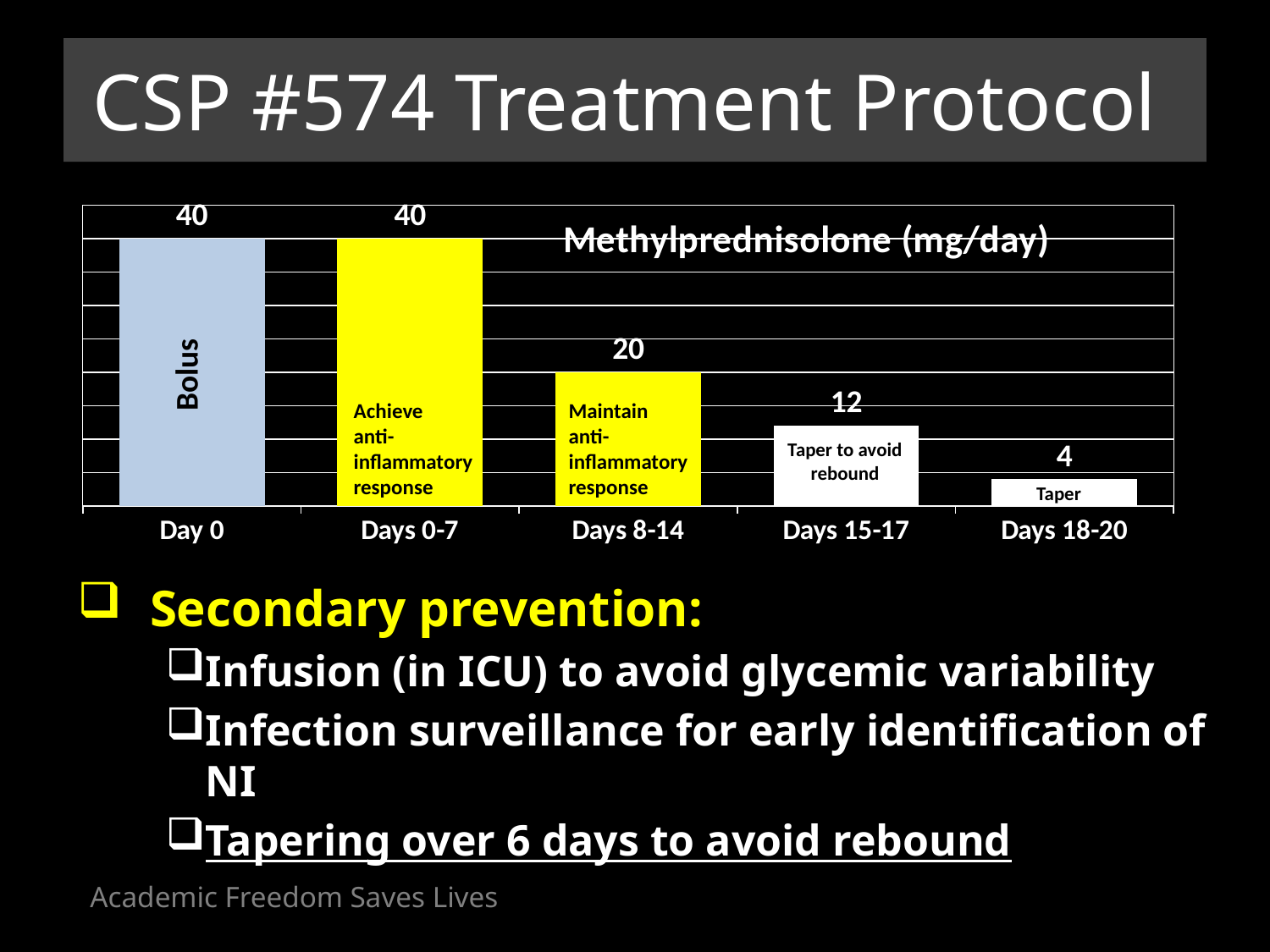
What is the methylprednisolone dose (mg/day) shown for Days 8-14? 20 Which is larger, the value for Days 8-14 or the value for Days 15-17? Days 8-14 What is the difference between the values for Days 0-7 and Days 8-14? 20 What is the title shown inside the chart area? Methylprednisolone (mg/day) What is the value shown for Days 15-17? 12 What is the value shown for Days 18-20? 4 What is the difference between the values for Days 15-17 and Days 18-20? 8 What is the value shown for Day 0? 40 How many categories are shown on the x axis? 5 Do the values rise or fall from Days 0-7 to Days 18-20? Fall Which category has the lowest value? Days 18-20 What kind of chart is shown on the slide? Bar chart